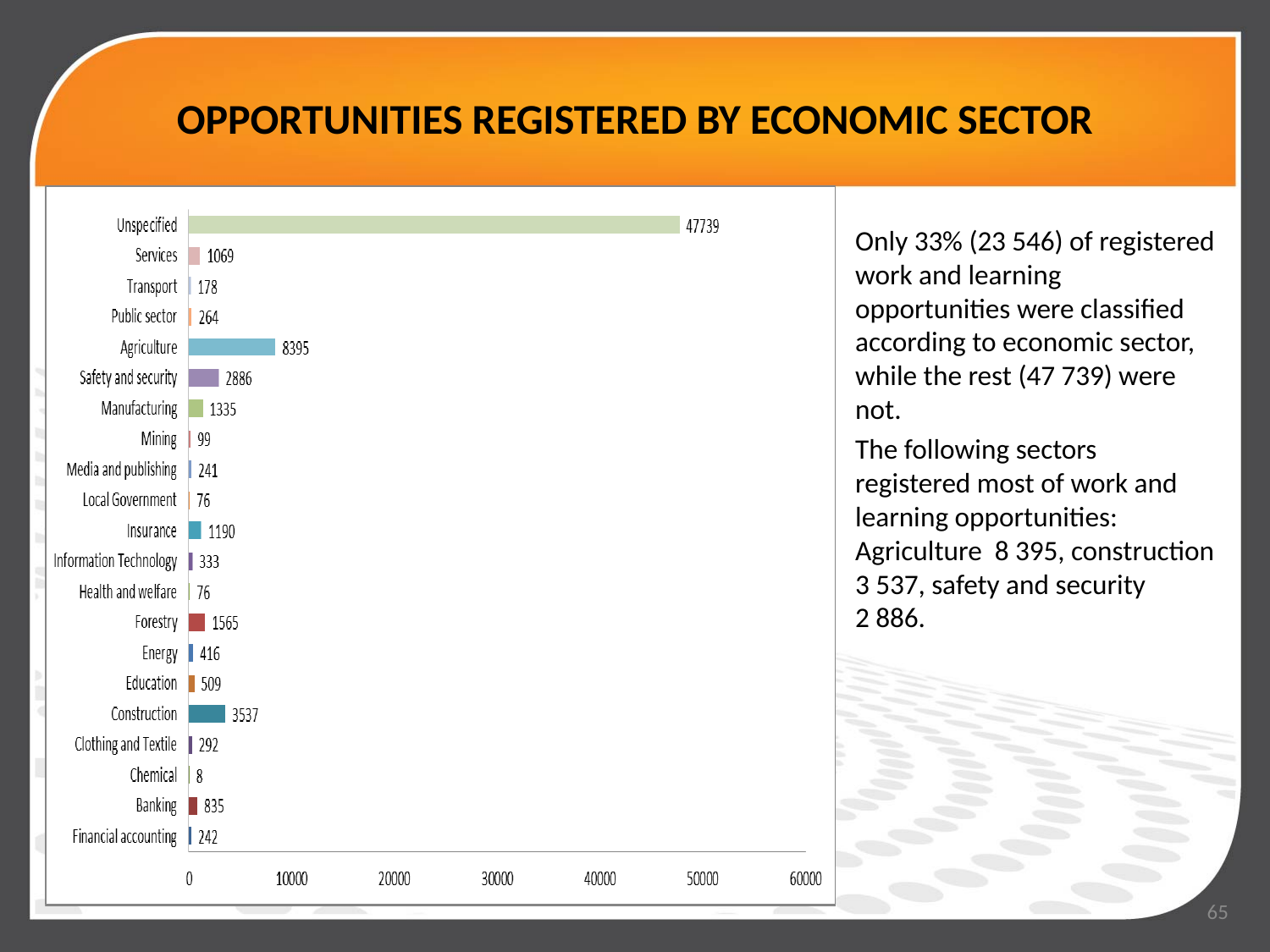
What is the difference between the values for Agriculture and Construction? 4858 What is the value for Safety and security? 2886 What is the value for Construction? 3537 What is the value for Agriculture? 8395 What is the value for Banking? 835 What kind of chart is shown on the slide? bar chart How many categories are shown in the chart? 21 Which category has the lowest value? Chemical Which is larger, the value for Forestry or the value for Manufacturing? Forestry What is the highest value shown on the horizontal axis? 60000 Which category has the highest value? Unspecified Is the value for Unspecified greater or less than 40000? greater